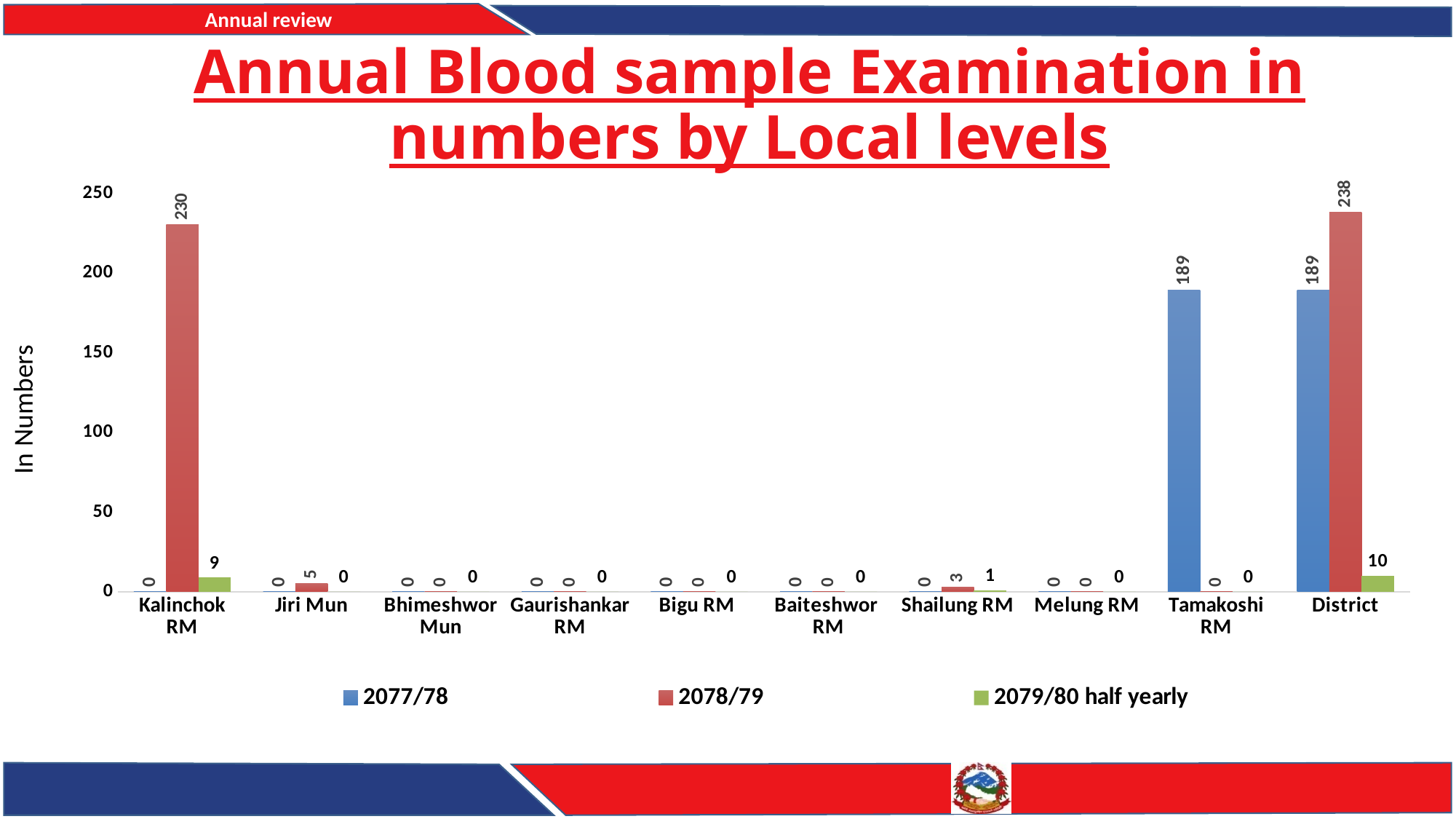
Is the 2078/79 value for Kalinchok RM greater or less than 200? greater What is the value for Kalinchok RM in the 2078/79 series? 230 What is the difference between the District value and the Kalinchok RM value in the 2078/79 series? 8 What is the value for Jiri Mun in the 2078/79 series? 5 What is the label of the y axis? In Numbers How many local level categories are shown on the x axis? 10 What is the value for District in the 2079/80 half yearly series? 10 How many series does the legend list? 3 Which local level has the highest value in the 2078/79 series? District What is the value for Tamakoshi RM in the 2077/78 series? 189 Which is larger: the 2079/80 half yearly value for Kalinchok RM or for District? District What kind of chart is shown on the slide? bar chart